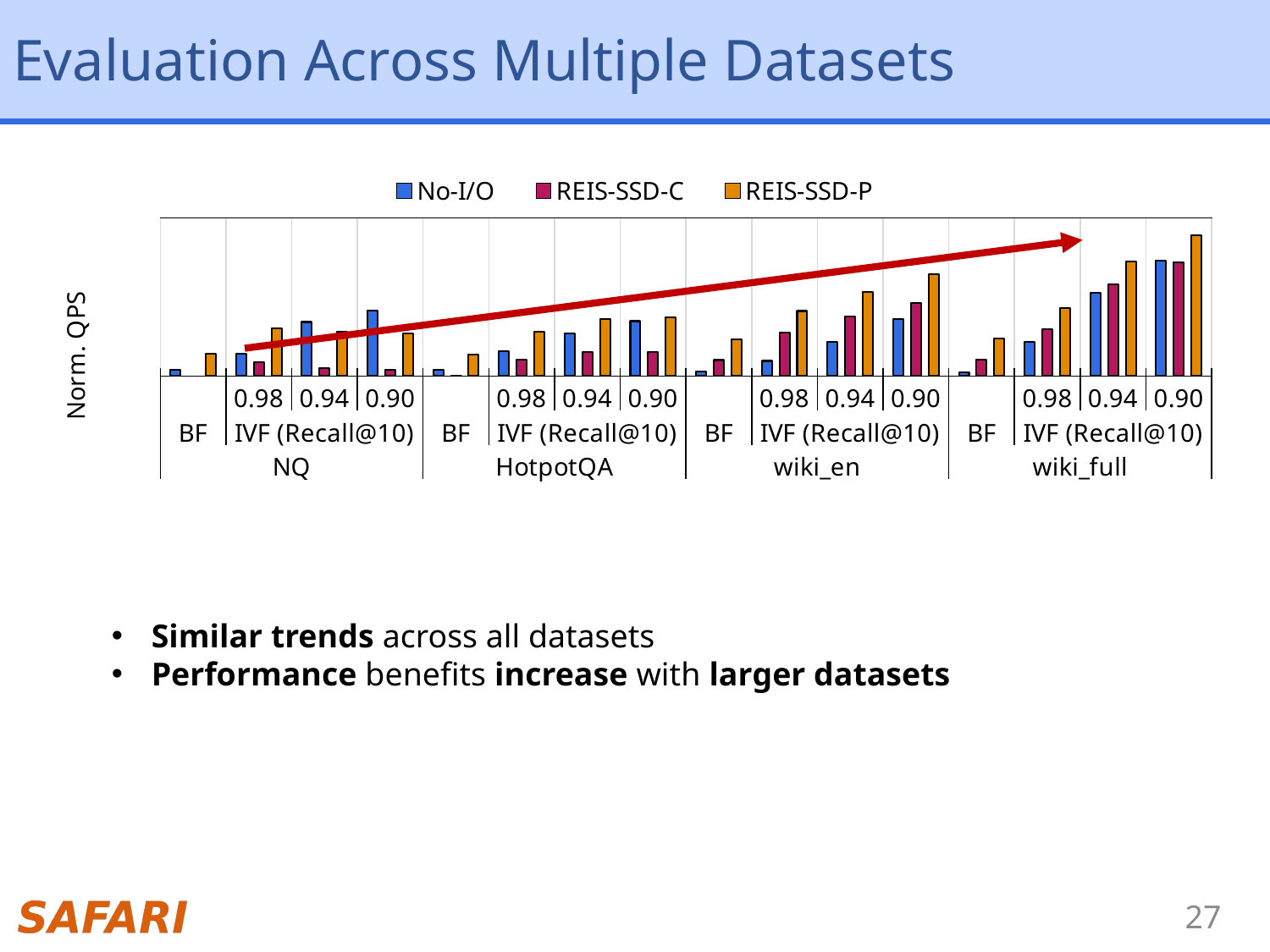
What is the label on the y axis? Norm. QPS Which series has the tallest bar in the whole chart? REIS-SSD-P How many Recall@10 levels are shown for IVF within each dataset? 3 How many series does the legend list? 3 What kind of chart is shown on the slide? bar chart For which dataset and configuration is the tallest bar in the chart? wiki_full, IVF (Recall@10) 0.90 Within the NQ dataset, which series has the tallest bar? No-I/O How many datasets are shown along the x axis? 4 For wiki_full at IVF Recall@10 of 0.90, which is larger: No-I/O or REIS-SSD-P? REIS-SSD-P For NQ at IVF Recall@10 of 0.90, which is larger: No-I/O or REIS-SSD-C? No-I/O In the wiki_full IVF groups, do the REIS-SSD-P bars rise or fall as Recall@10 goes from 0.98 to 0.90? rise